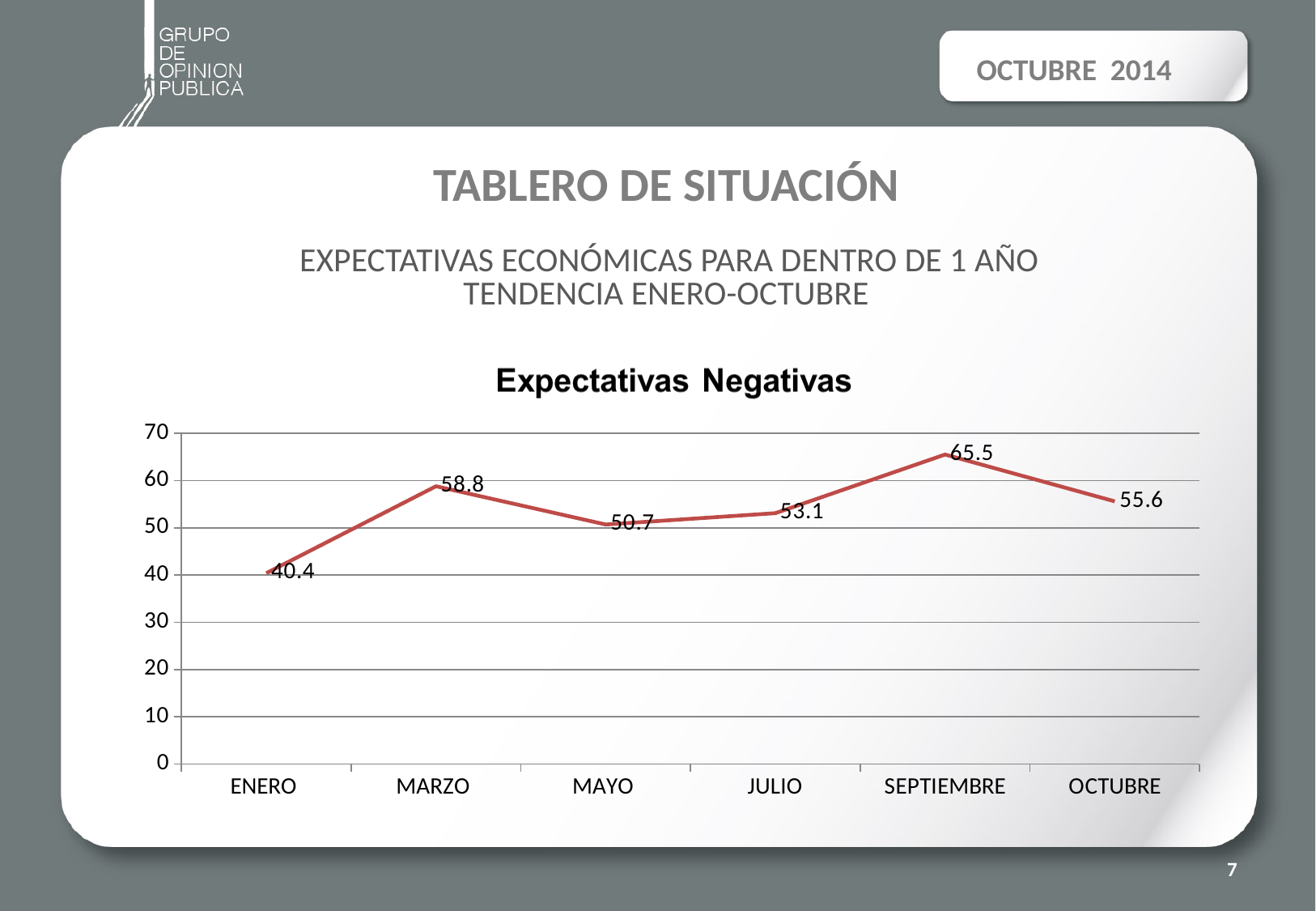
Is the value for SEPTIEMBRE greater or less than 60? greater Which is larger, the value for MAYO or the value for JULIO? JULIO What is the value for MARZO? 58.8 Does the value rise or fall from SEPTIEMBRE to OCTUBRE? fall Which month has the lowest value? ENERO What is the value for ENERO? 40.4 Which month has the highest value? SEPTIEMBRE What is the title of the chart? Expectativas Negativas What kind of chart is shown? line chart What is the value for OCTUBRE? 55.6 What is the difference between the values for SEPTIEMBRE and ENERO? 25.1 How many months are plotted on the x axis? 6